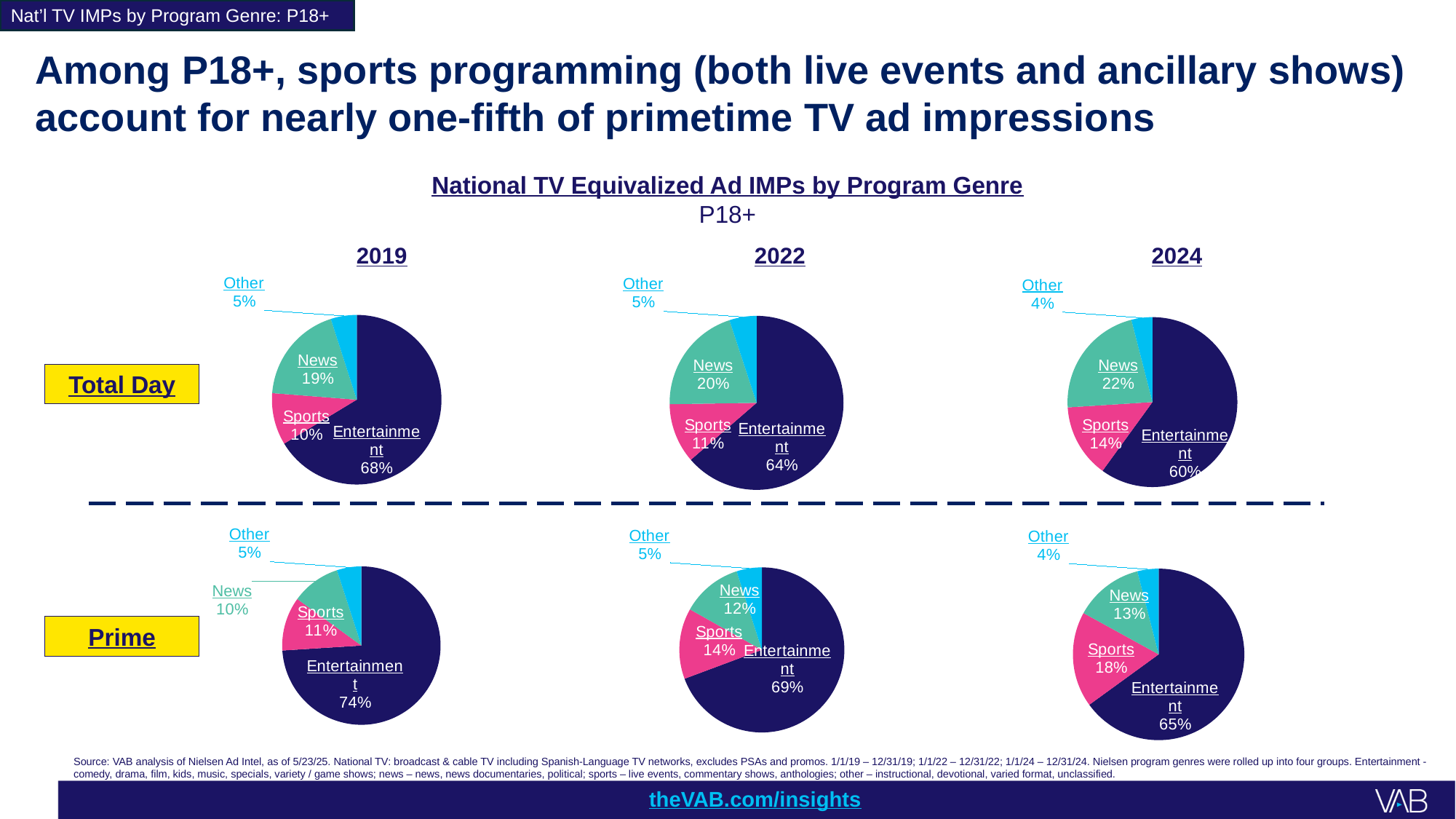
In the Total Day 2019 pie chart, what share of ad impressions does Entertainment account for? 68% What type of chart is used on this slide? Pie chart In the Prime 2022 pie chart, what is the difference between the Entertainment share and the Sports share? 55 percentage points In the Total Day 2019 pie chart, which is larger, News or Sports? News How many slices does each pie chart on the slide have? 4 In the Total Day 2024 pie chart, what is the value for News? 22% How many pie charts are shown on the slide? 6 Across the Prime pie charts from 2019 to 2024, does the Sports share rise or fall? Rise In the Total Day 2022 pie chart, which genre has the largest share? Entertainment In the Prime 2024 pie chart, what is the value for Sports? 18% In the Prime 2024 pie chart, which is larger, Sports or News? Sports In the Prime 2019 pie chart, which genre has the smallest share? Other